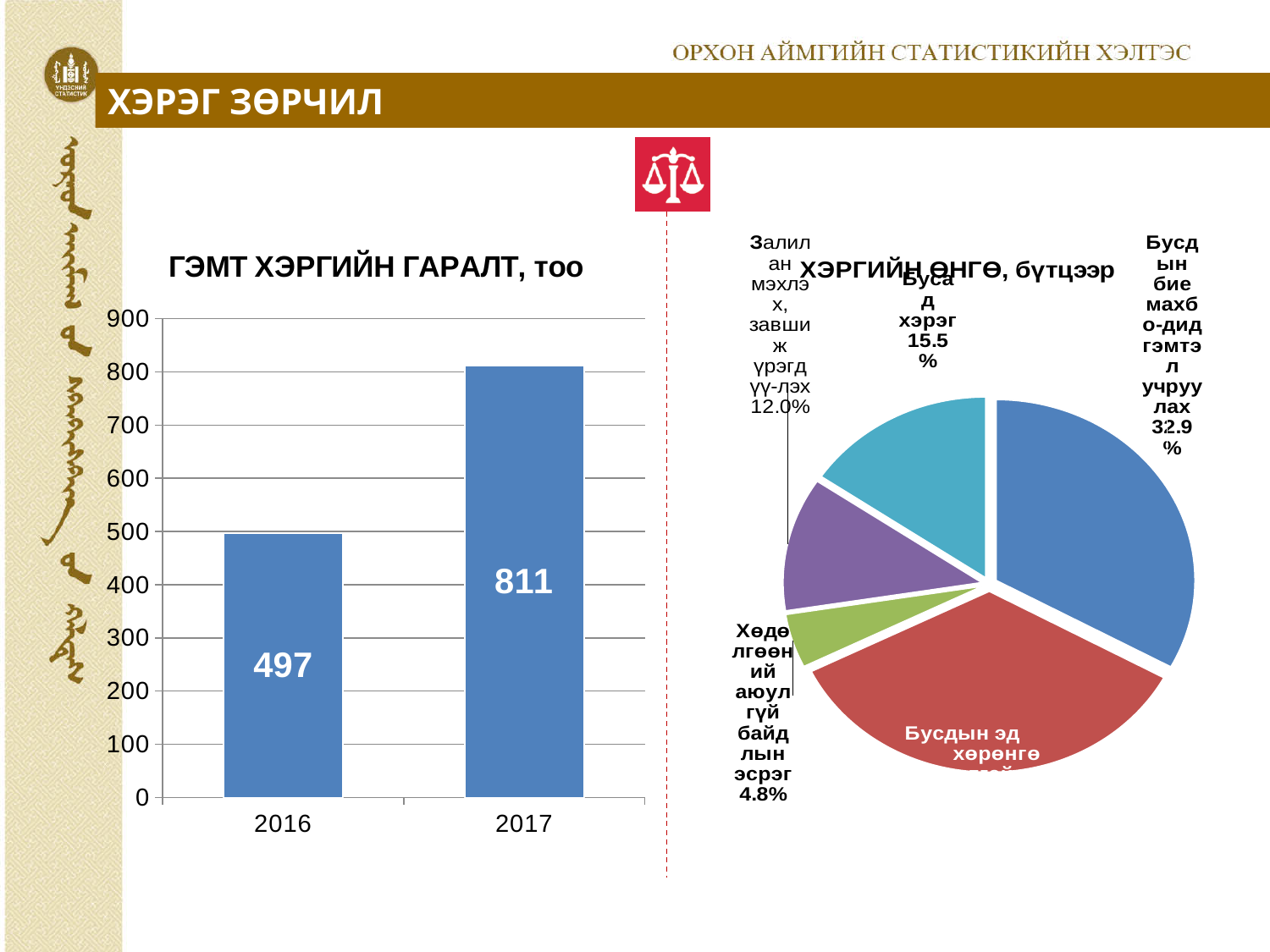
In the bar chart 'ГЭМТ ХЭРГИЙН ГАРАЛТ, тоо', what is the value for 2017? 811 What kind of chart is the left chart 'ГЭМТ ХЭРГИЙН ГАРАЛТ, тоо'? bar chart In the bar chart 'ГЭМТ ХЭРГИЙН ГАРАЛТ, тоо', which year has the higher value? 2017 In the bar chart 'ГЭМТ ХЭРГИЙН ГАРАЛТ, тоо', how many years are shown? 2 What kind of chart is the right chart 'ХЭРГИЙН ӨНГӨ, бүтцээр'? pie chart In the bar chart 'ГЭМТ ХЭРГИЙН ГАРАЛТ, тоо', what is the difference between the 2017 and 2016 values? 314 In the bar chart 'ГЭМТ ХЭРГИЙН ГАРАЛТ, тоо', do the values rise or fall from 2016 to 2017? rise In the pie chart 'ХЭРГИЙН ӨНГӨ, бүтцээр', which slice is the smallest? Хөдөлгөөний аюулгүй байдлын эсрэг In the pie chart 'ХЭРГИЙН ӨНГӨ, бүтцээр', what share is 'Хөдөлгөөний аюулгүй байдлын эсрэг'? 4.8% In the bar chart 'ГЭМТ ХЭРГИЙН ГАРАЛТ, тоо', is the value for 2016 greater or less than 500? less In the pie chart 'ХЭРГИЙН ӨНГӨ, бүтцээр', what share is 'Бусад хэрэг'? 15.5% In the bar chart 'ГЭМТ ХЭРГИЙН ГАРАЛТ, тоо', what is the value for 2016? 497